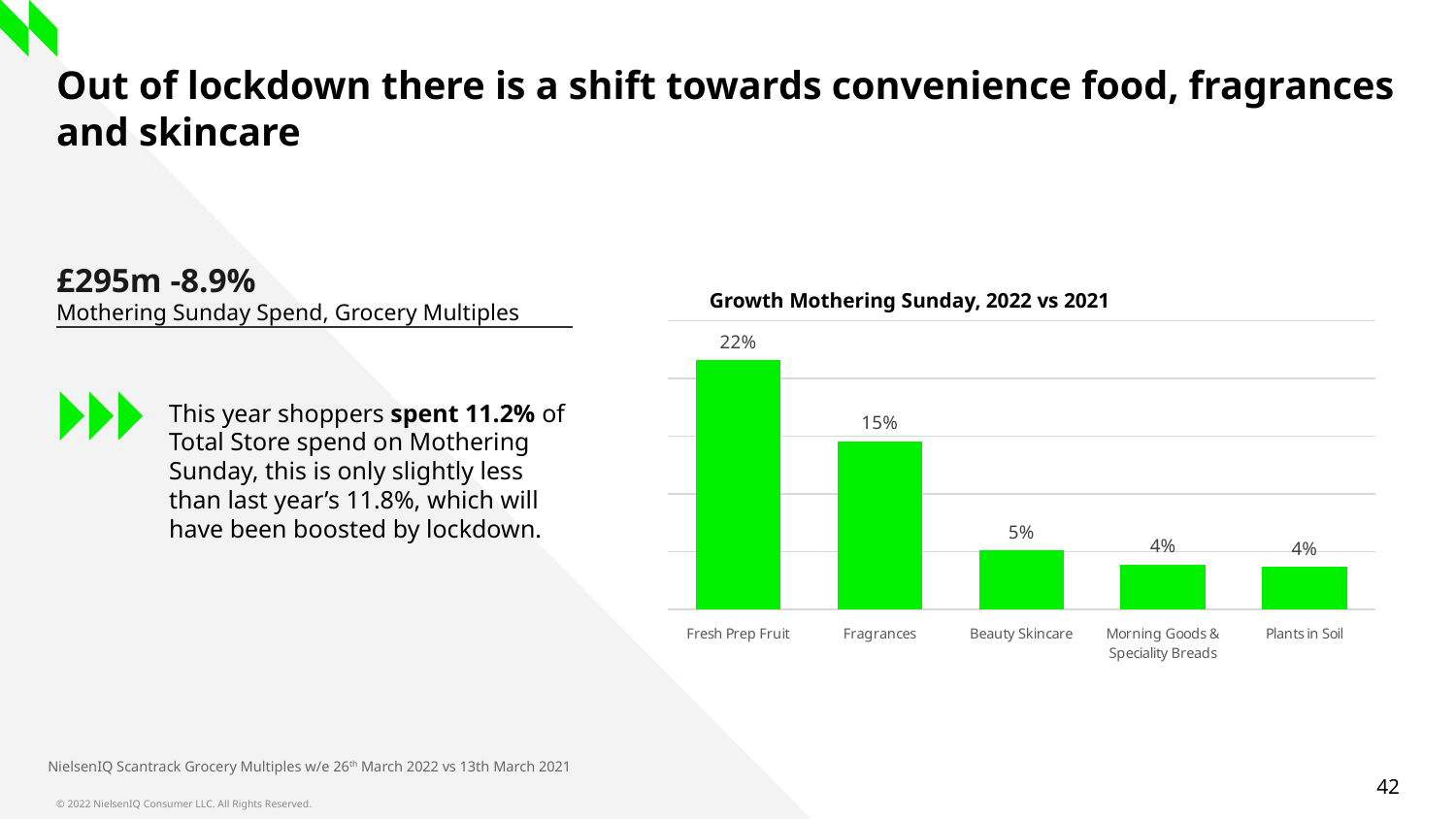
Which has higher growth, Fragrances or Beauty Skincare? Fragrances What is the growth value for Fragrances? 15% How many categories are shown in the chart? 5 Do the values rise or fall from left to right across the categories? Fall What is the difference in growth between Fresh Prep Fruit and Fragrances? 7% Which category has the highest growth? Fresh Prep Fruit What is the title of the chart? Growth Mothering Sunday, 2022 vs 2021 What is the growth value for Beauty Skincare? 5% What kind of chart is shown on the slide? Bar chart What is the growth value for Morning Goods & Speciality Breads? 4% What is the difference in growth between Fragrances and Beauty Skincare? 10% What is the growth value for Fresh Prep Fruit? 22%